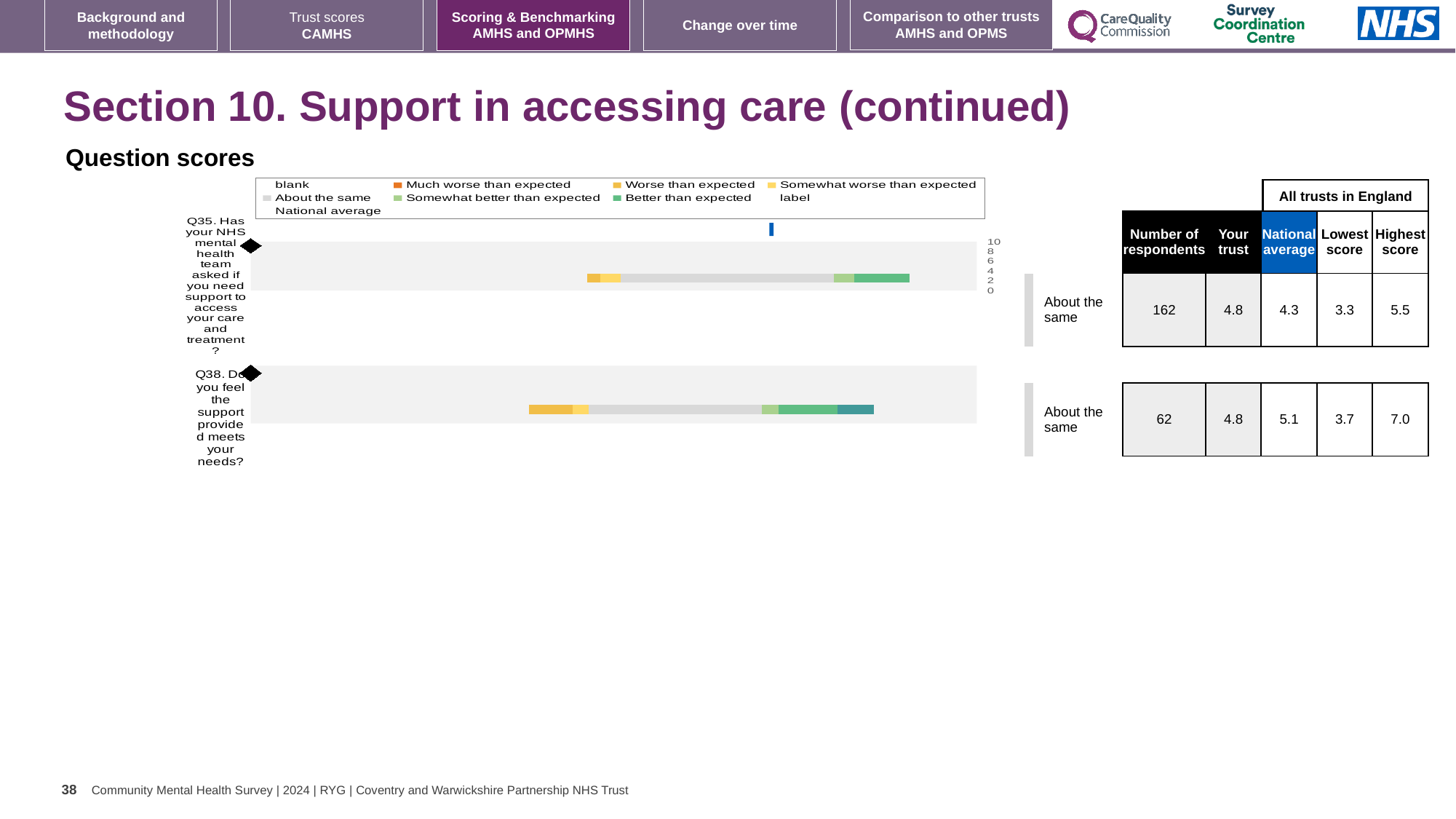
How many respondents answered Q35? 162 What is the difference between the highest and lowest scores for Q38 across all trusts in England? 3.3 How many questions (categories) are plotted in the question scores chart? 2 What benchmark category is shown next to both Q35 and Q38 in the chart? About the same What is the 'Your trust' score for Q35 (Has your NHS mental health team asked if you need support to access your care and treatment?)? 4.8 Which question had more respondents, Q35 or Q38? Q35 What kind of chart is used to show the question scores on this slide? bar chart What is the highest score among all trusts in England for Q38? 7.0 What is the lowest score among all trusts in England for Q35? 3.3 For Q35, which is larger: the 'Your trust' score or the national average? Your trust What is the national average score for Q38 (Do you feel the support provided meets your needs?)? 5.1 For Q38, which is larger: the 'Your trust' score or the national average? National average